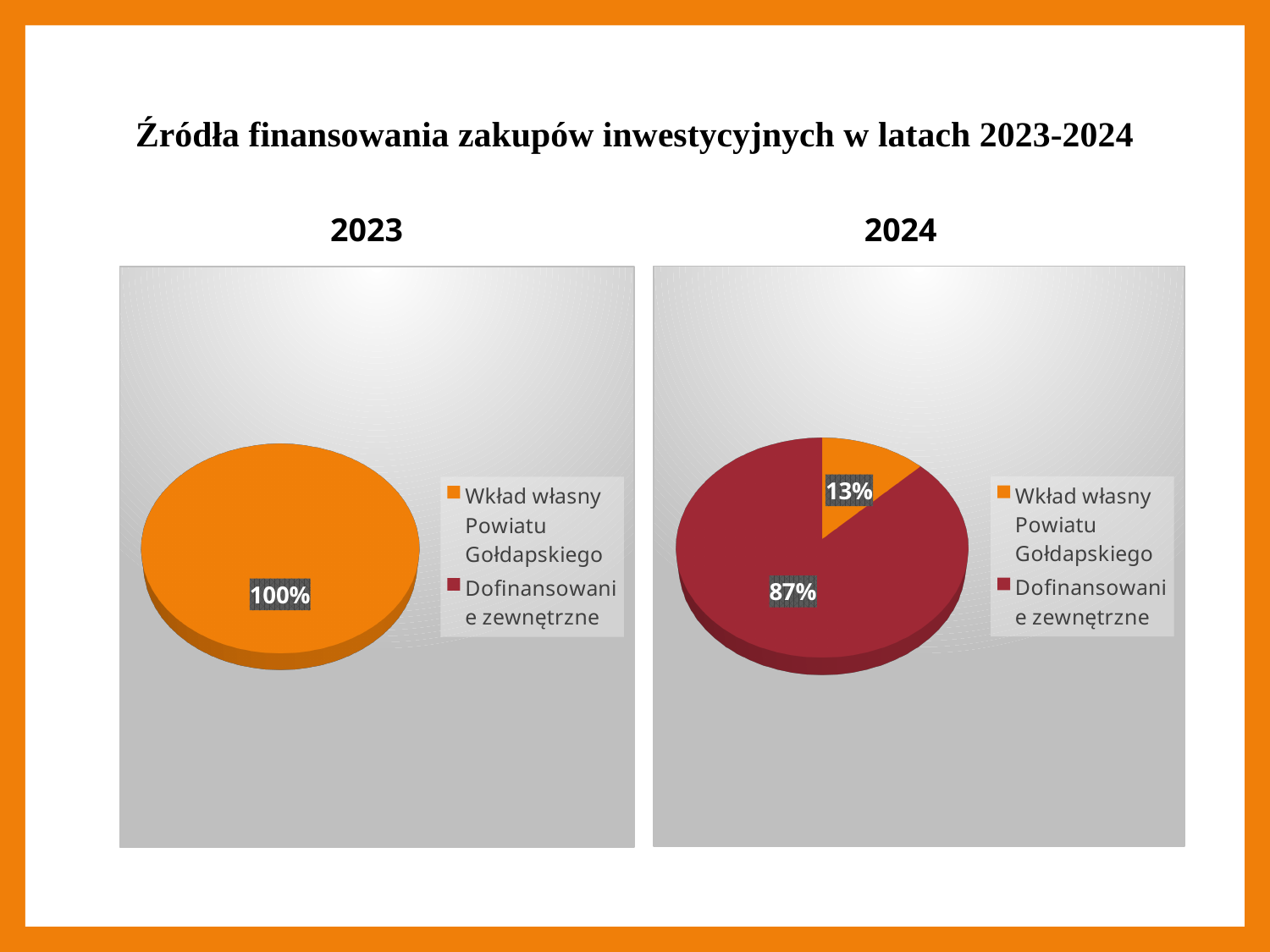
How many entries does the legend of the 2024 chart list? 2 How many charts are shown on the slide? 2 In the 2023 chart, what share does Wkład własny Powiatu Gołdapskiego have? 100% In the 2024 chart, which category has the largest slice? Dofinansowanie zewnętrzne In the 2024 chart, what share does Dofinansowanie zewnętrzne have? 87% What is the title of the 2024 chart? 2024 In the 2024 chart, what colour is the Dofinansowanie zewnętrzne slice? Dark red In the 2024 chart, which category has the smallest slice? Wkład własny Powiatu Gołdapskiego In the 2024 chart, which is larger: Wkład własny Powiatu Gołdapskiego or Dofinansowanie zewnętrzne? Dofinansowanie zewnętrzne What kind of chart is the 2023 chart? Pie chart In the 2024 chart, what share does Wkład własny Powiatu Gołdapskiego have? 13% In the 2024 chart, what is the difference in percentage points between Dofinansowanie zewnętrzne and Wkład własny Powiatu Gołdapskiego? 74 percentage points